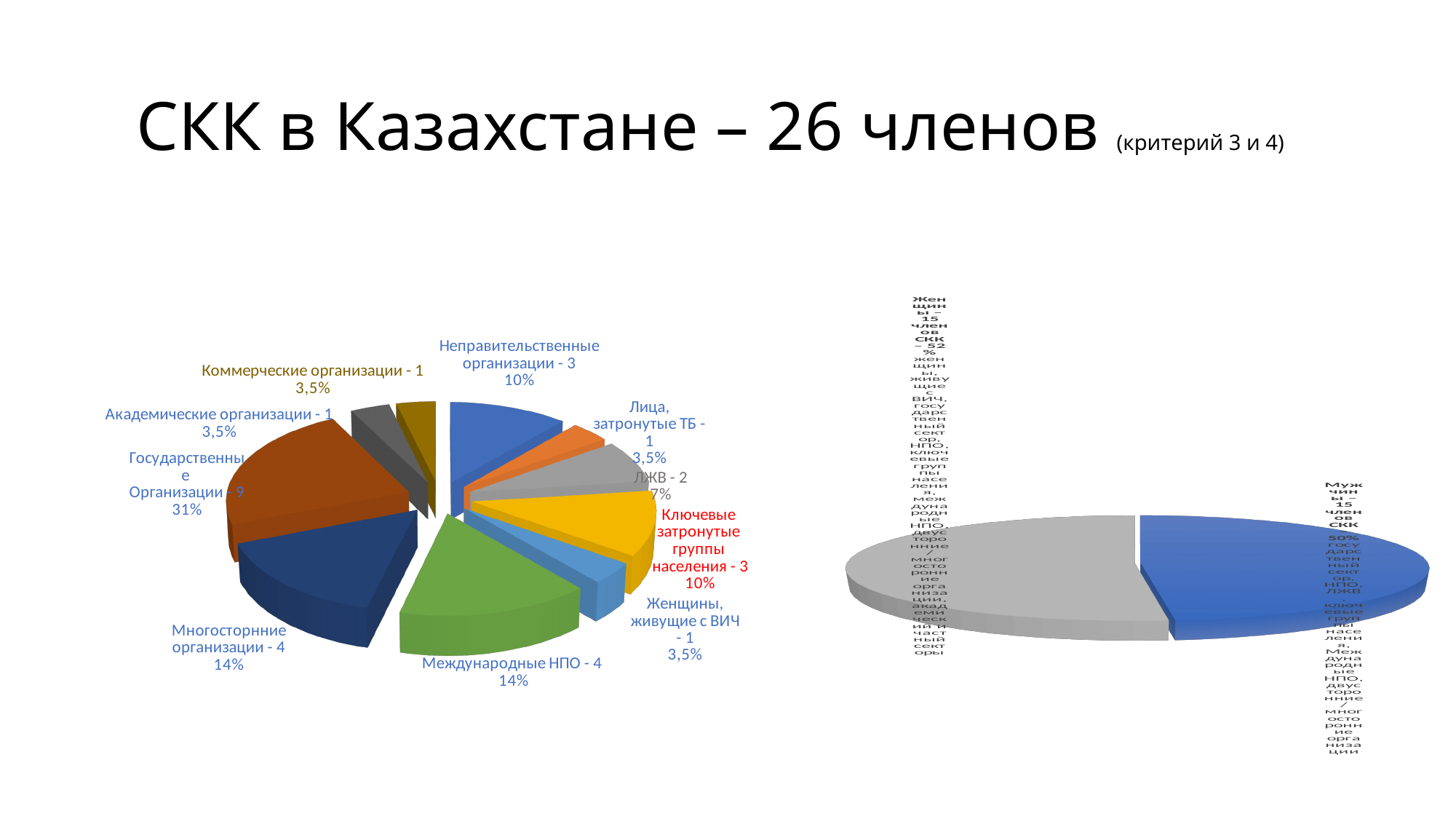
In the left pie chart, which has the larger share: Неправительственные организации or ЛЖВ? Неправительственные организации In the left pie chart, what share is shown for ЛЖВ? 7% In the left pie chart, what is the difference in members between Государственные Организации and Многосторонние организации? 5 In the left pie chart, how many members are listed for Международные НПО? 4 In the left pie chart, which category has the largest share? Государственные Организации In the left pie chart, what share is shown for Государственные Организации? 31% In the left pie chart, what share is shown for Коммерческие организации? 3,5% In the right pie chart, how many members of the СКК are listed as Мужчины? 15 In the right pie chart, how many slices are there? 2 In the left pie chart, how many categories (slices) are there? 10 What kind of chart is the left chart on the slide? pie chart In the right pie chart, what percentage is shown for Женщины? 52%